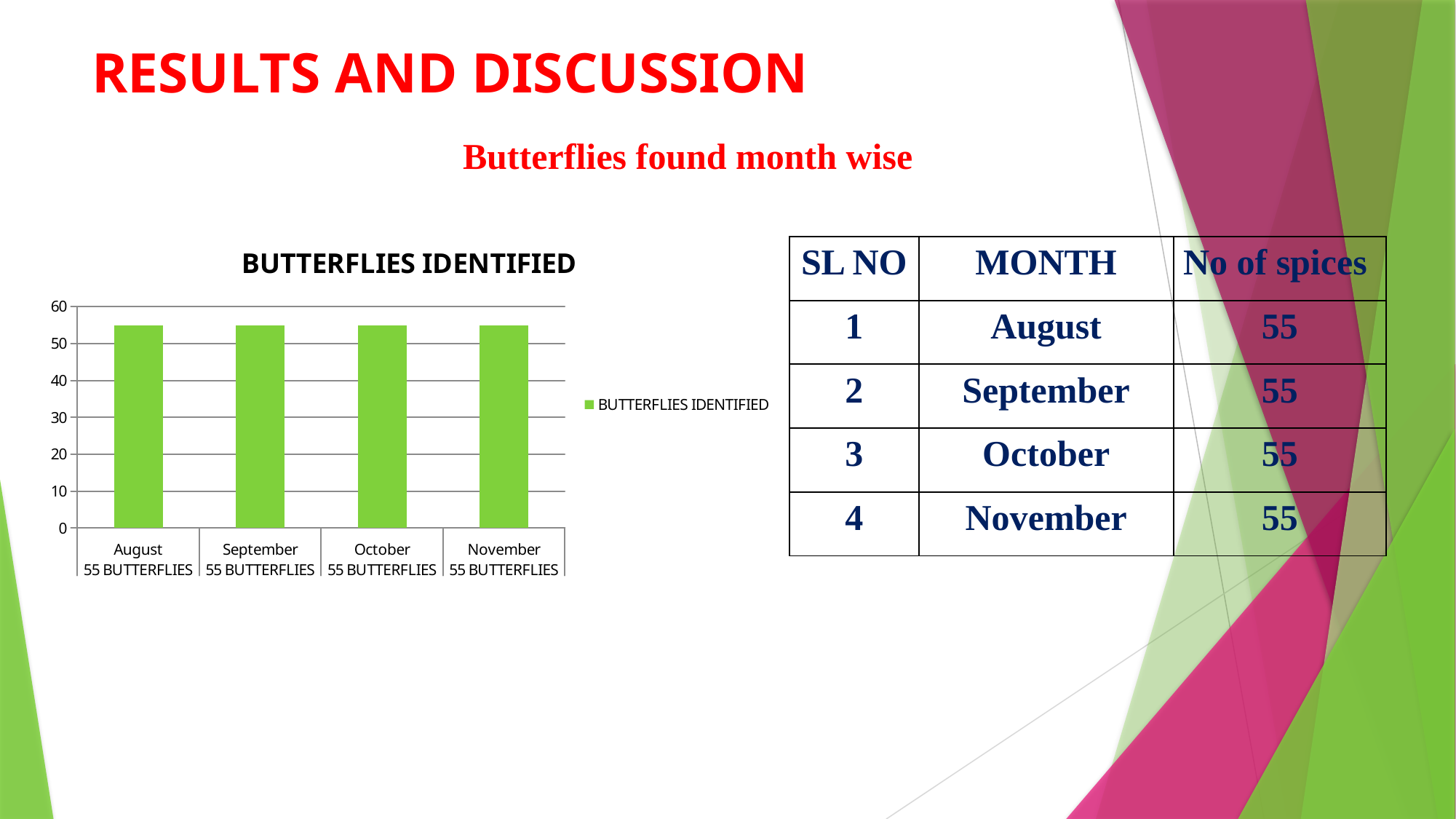
What is the value for August in the BUTTERFLIES IDENTIFIED chart? 55 Is the value for August in the BUTTERFLIES IDENTIFIED chart greater or less than 60? less How many months are shown on the x axis of the BUTTERFLIES IDENTIFIED chart? 4 Do the values in the BUTTERFLIES IDENTIFIED chart rise, fall, or stay the same from August to November? stay the same Is the value for September in the BUTTERFLIES IDENTIFIED chart greater or less than 50? greater How many series does the legend of the BUTTERFLIES IDENTIFIED chart list? 1 What kind of chart is the BUTTERFLIES IDENTIFIED chart? bar chart What colour are the bars in the BUTTERFLIES IDENTIFIED chart? green What is the title of the chart on the slide? BUTTERFLIES IDENTIFIED What is the value for November in the BUTTERFLIES IDENTIFIED chart? 55 What is the value for October in the BUTTERFLIES IDENTIFIED chart? 55 What is the difference between the values for September and October in the BUTTERFLIES IDENTIFIED chart? 0